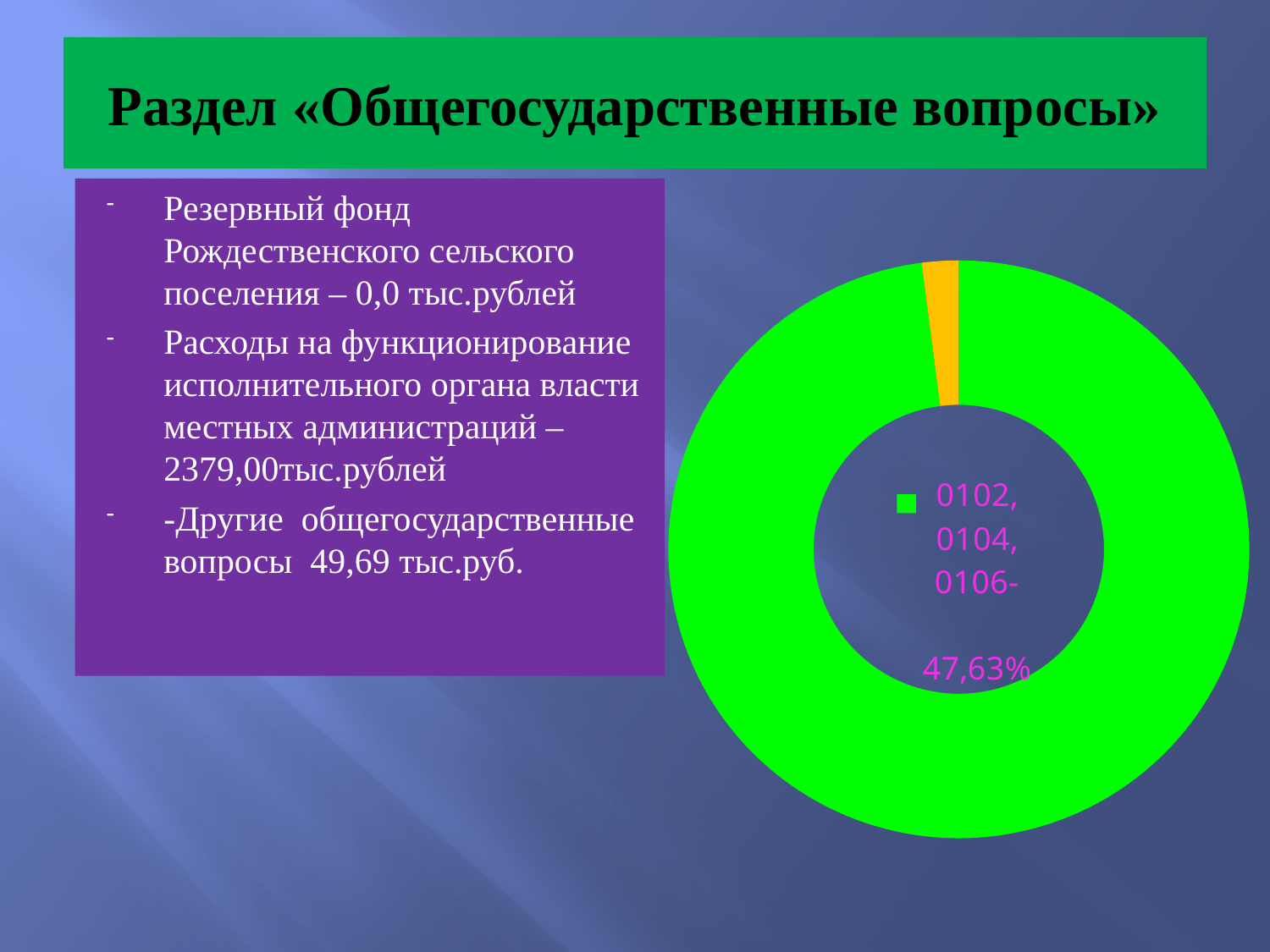
What is the label of the legend entry shown in the centre of the doughnut chart? 0102, 0104, 0106- 47,63% Which slice of the doughnut chart is larger, the green one or the orange one? the green one How many entries does the chart's legend list? 1 What colour is the slice that corresponds to the legend entry 0102, 0104, 0106? green Which slice of the doughnut chart is the smallest? the orange slice How many slices does the doughnut chart have? 2 What kind of chart is shown on the slide? doughnut (pie) chart What percentage is printed in the legend entry for 0102, 0104, 0106? 47,63%